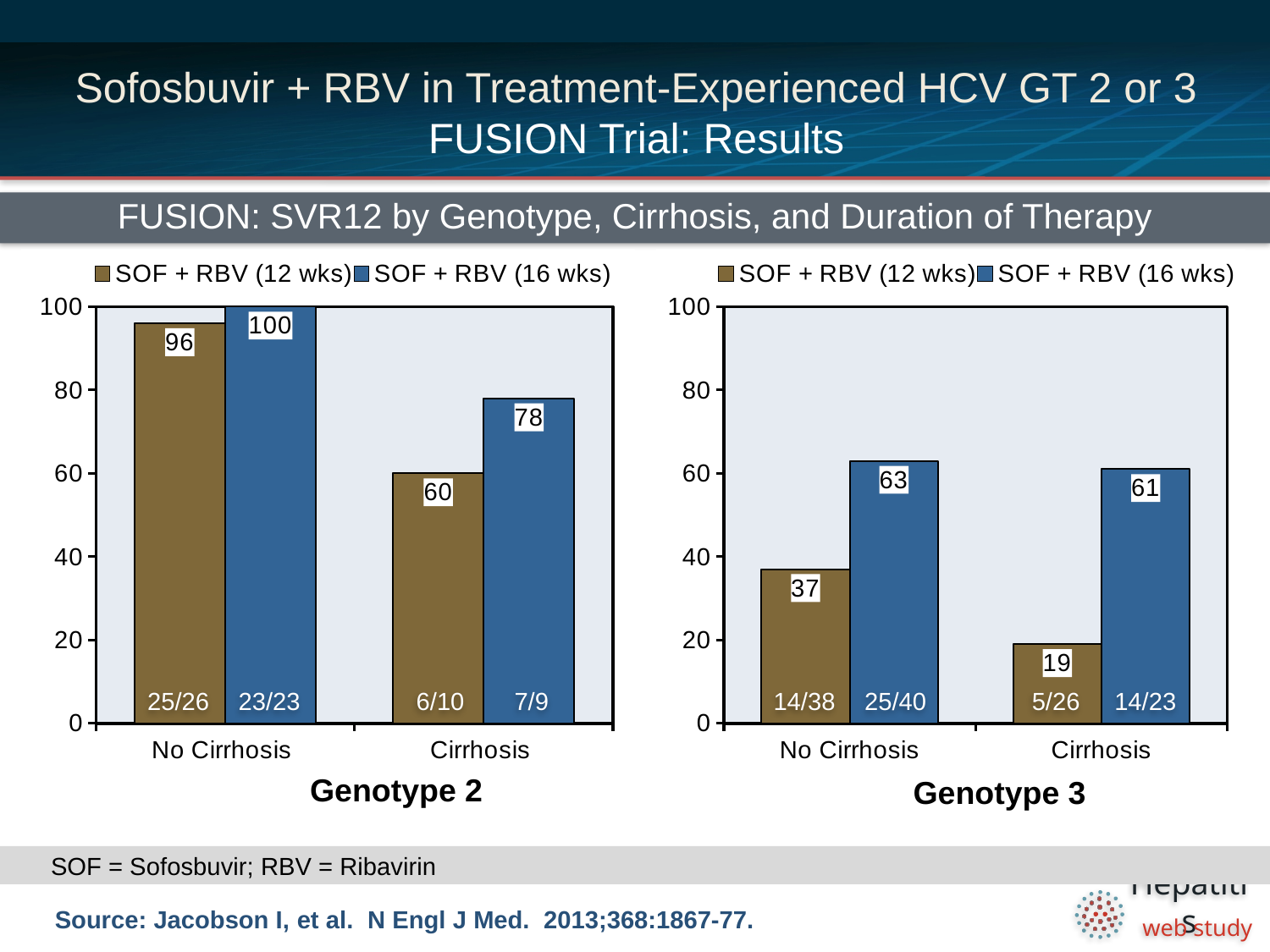
In the Genotype 3 chart, which is larger in the Cirrhosis group: SOF + RBV (12 wks) or SOF + RBV (16 wks)? SOF + RBV (16 wks) In the Genotype 2 chart, which bar has the highest value? SOF + RBV (16 wks), No Cirrhosis What kind of chart is the Genotype 3 chart? Bar chart In the Genotype 3 chart, what is the difference between the 16-week and 12-week values in the No Cirrhosis group? 26 In the Genotype 2 chart, what fraction is printed on the SOF + RBV (12 wks) bar for No Cirrhosis? 25/26 In the Genotype 3 chart, which bar has the lowest value? SOF + RBV (12 wks), Cirrhosis In the Genotype 3 chart, what is the value for SOF + RBV (16 wks) in the No Cirrhosis group? 63 In the Genotype 2 chart, what is the difference between the 16-week and 12-week values in the Cirrhosis group? 18 How many series does the legend of the Genotype 2 chart list? 2 In the Genotype 2 chart, what is the value for SOF + RBV (12 wks) in the No Cirrhosis group? 96 In the Genotype 2 chart, what is the value for SOF + RBV (16 wks) in the Cirrhosis group? 78 In the Genotype 3 chart, what is the value for SOF + RBV (12 wks) in the Cirrhosis group? 19